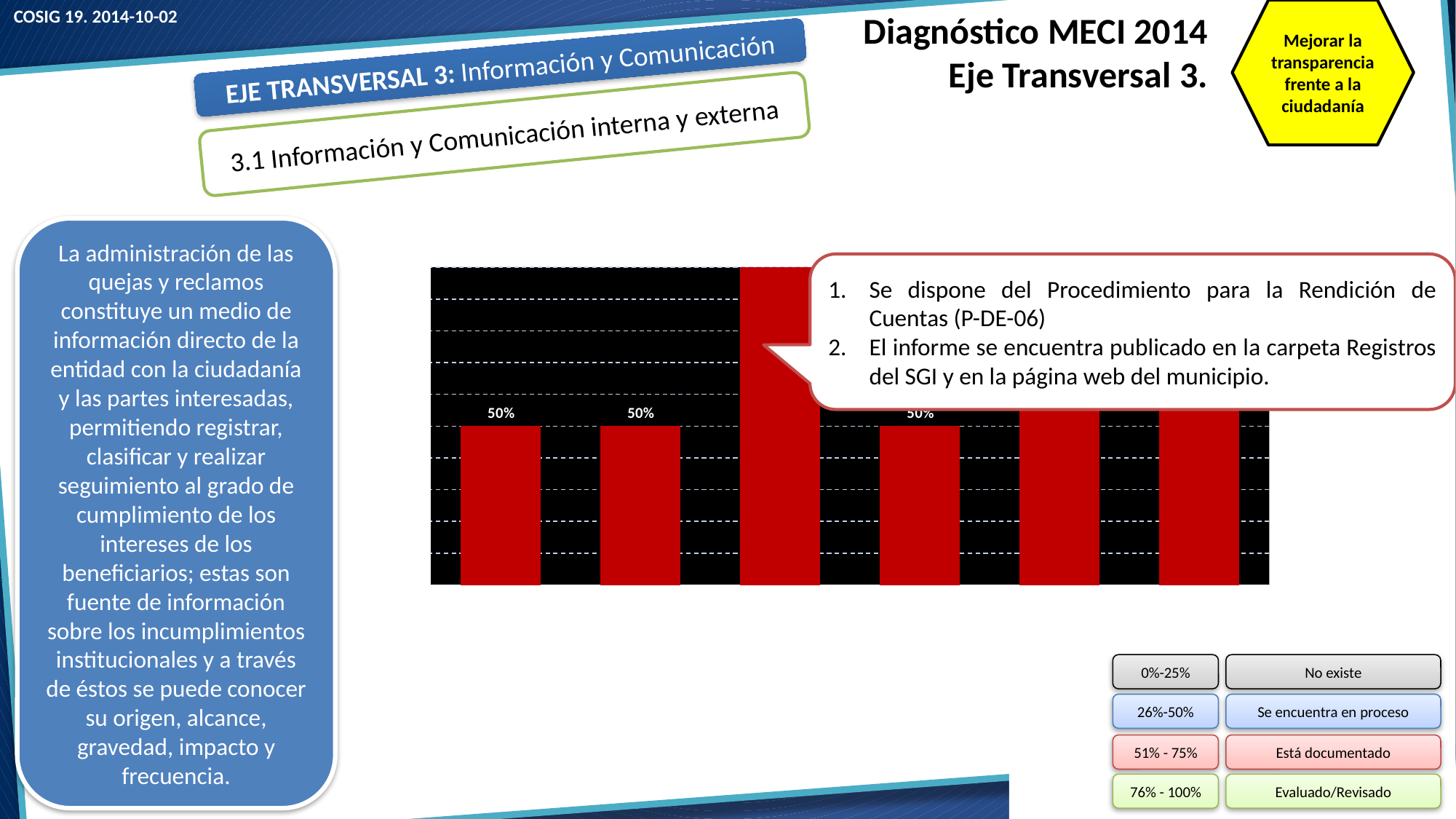
What colour are the bars in the chart? Red What is the data label on the second bar from the left? 50% Which bar is the tallest in the chart? The third bar from the left What kind of chart is shown on the slide? Bar chart What is the background colour of the chart's plot area? Black What is the data label on the fourth bar from the left? 50% What is the data label on the first bar from the left? 50% What is the difference between the values of the first and second bars from the left? 0% How many bars are plotted in the chart? 6 Which is taller, the first bar from the left or the third bar from the left? The third bar